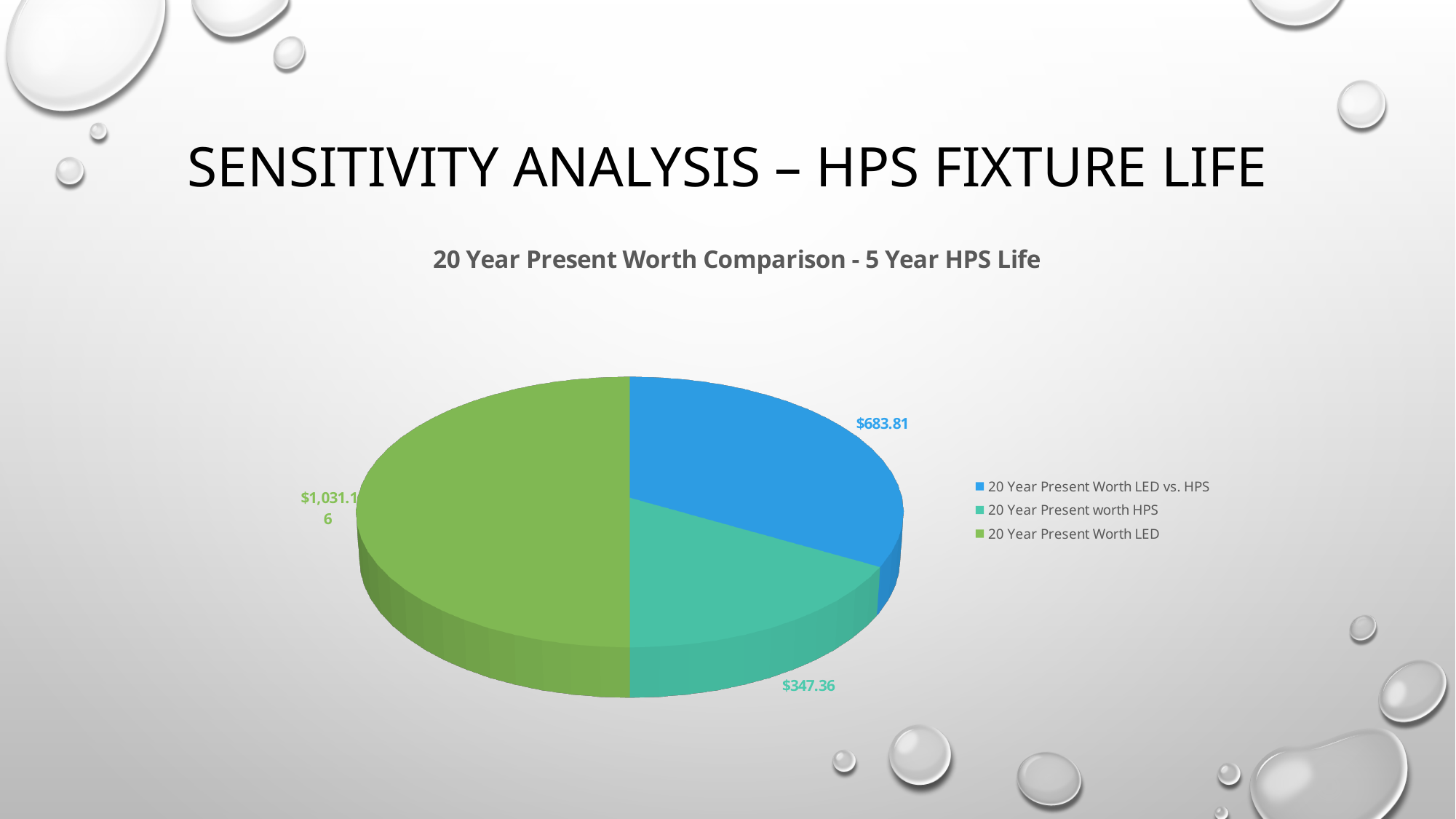
Which slice of the pie is the largest? 20 Year Present Worth LED How many slices does the pie chart have? 3 What colour is the 20 Year Present Worth LED slice? Green Which slice of the pie is the smallest? 20 Year Present worth HPS What is the value of the 20 Year Present Worth LED vs. HPS slice? $683.81 What is the title of the chart? 20 Year Present Worth Comparison - 5 Year HPS Life What is the value of the 20 Year Present worth HPS slice? $347.36 What is the value of the 20 Year Present Worth LED slice? $1,031.16 What is the difference between the 20 Year Present Worth LED value and the 20 Year Present worth HPS value? $683.80 What type of chart is shown on the slide? Pie chart Which is larger, the 20 Year Present Worth LED vs. HPS value or the 20 Year Present worth HPS value? 20 Year Present Worth LED vs. HPS How many entries does the legend list? 3